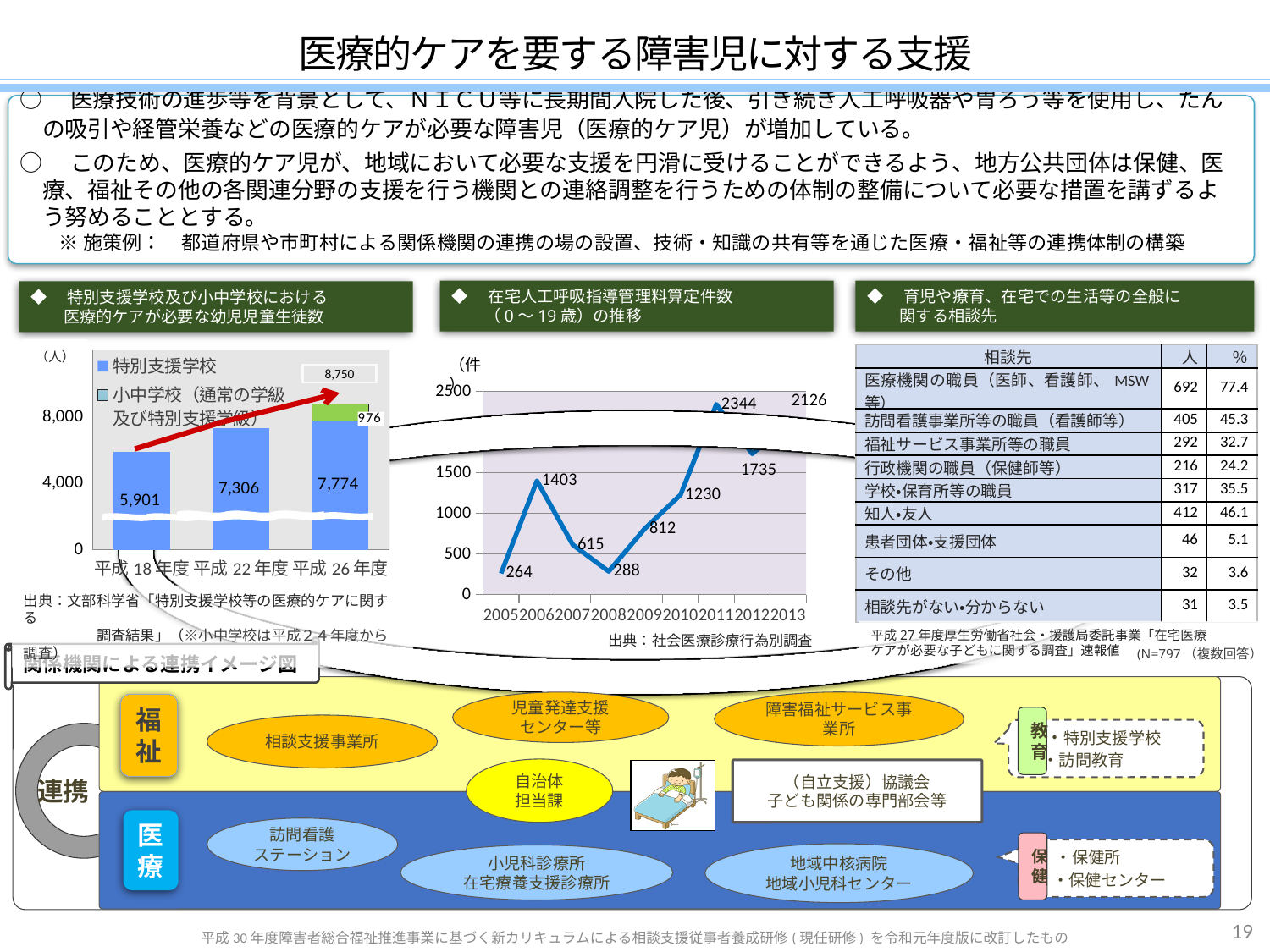
In the line chart in the middle, which year has the lowest value? 2005 In the bar chart on the left (特別支援学校及び小中学校における医療的ケアが必要な幼児児童生徒数), what is the value for 特別支援学校 in 平成18年度? 5,901 In the bar chart on the left, what is the value for 小中学校 in 平成26年度? 976 In the line chart in the middle, what is the difference between the 2011 value and the 2012 value? 609 In the bar chart on the left, does the 特別支援学校 value rise or fall from 平成18年度 to 平成26年度? rise In the bar chart on the left, what is the value for 特別支援学校 in 平成26年度? 7,774 In the bar chart on the left, how much larger is the 特別支援学校 value in 平成22年度 than in 平成18年度? 1,405 In the bar chart on the left, what is the total shown for 平成26年度? 8,750 In the line chart in the middle, which year has the highest value? 2011 What kind of chart is the middle chart showing 在宅人工呼吸指導管理料算定件数の推移? line chart In the line chart in the middle (在宅人工呼吸指導管理料算定件数の推移), what is the value for 2006? 1403 In the bar chart on the left, how many fiscal-year categories are shown on the x axis? 3